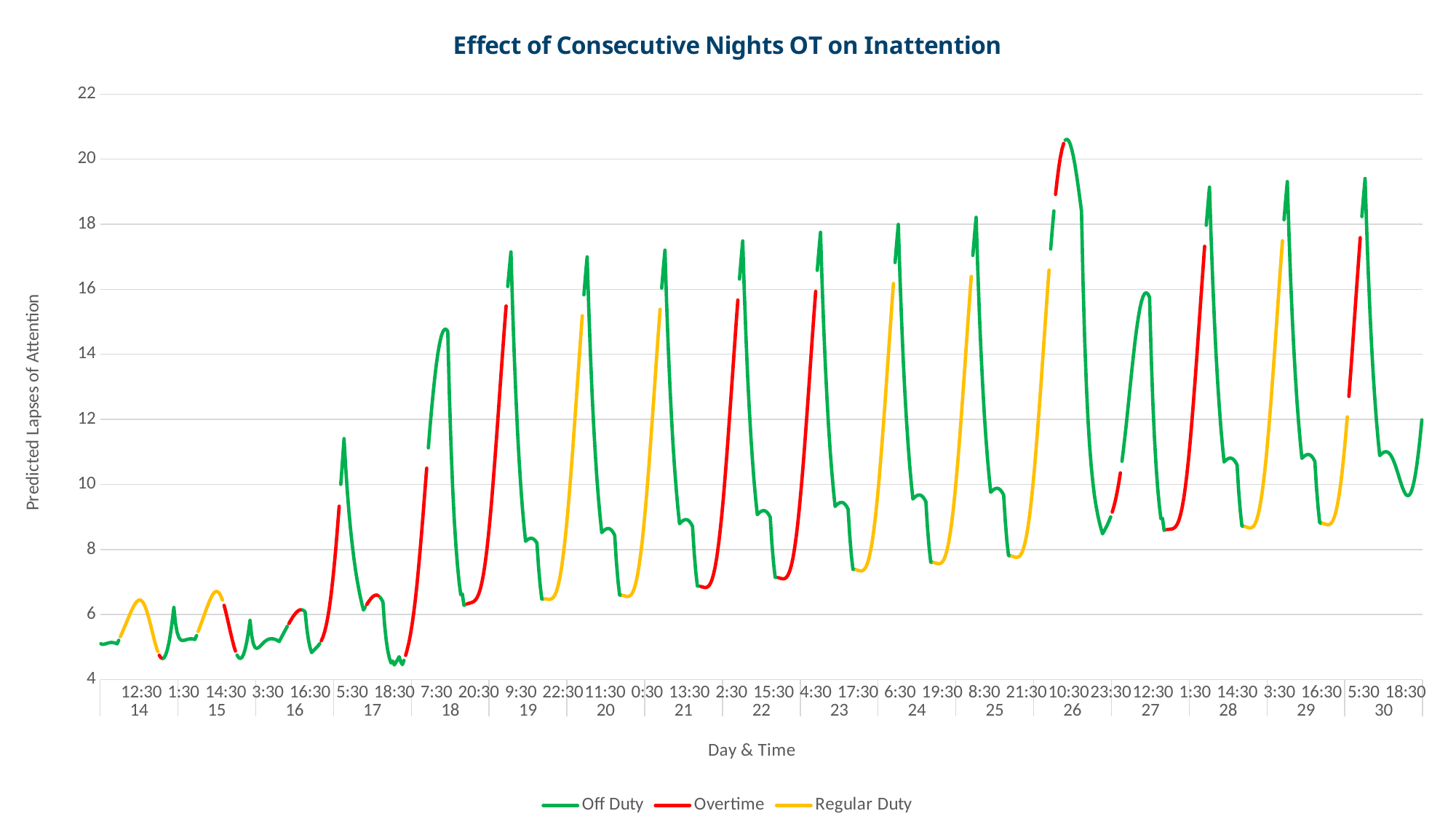
Which day has the highest peak on the chart? 26 What is the label of the vertical axis? Predicted Lapses of Attention Is the value of the line at the start of day 14 greater or less than 6? less What is the title of the chart? Effect of Consecutive Nights OT on Inattention Which series is drawn in red? Overtime How many series does the legend list? 3 Do the peaks of the line generally rise or fall from day 14 to day 26? rise Is the highest peak of the line, on day 26, greater or less than 18? greater What kind of chart is shown on the slide? line chart Is the peak of the line on day 18 greater or less than 14? greater How many days are labelled along the x axis? 17